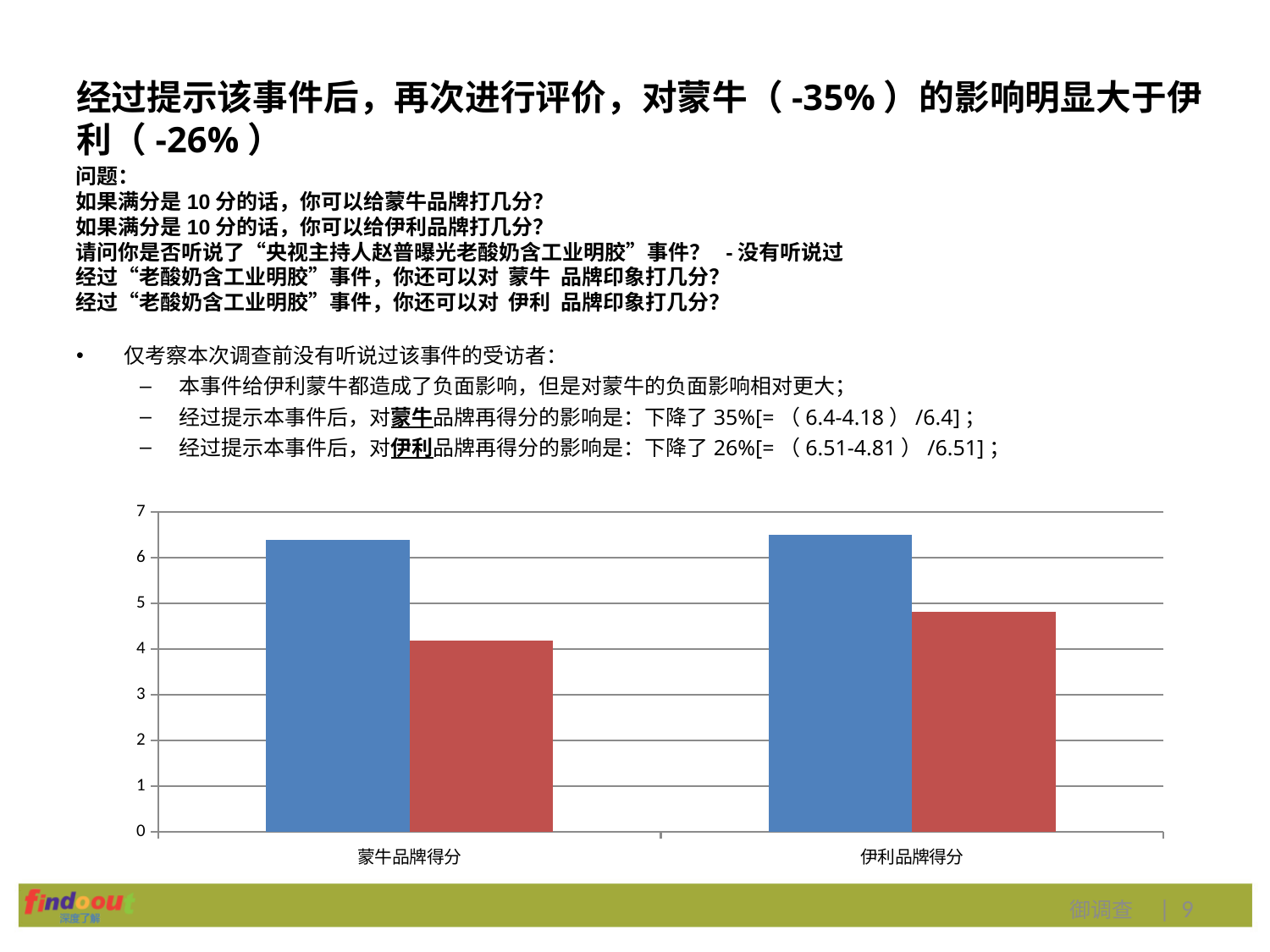
Is the value of the red bar for 蒙牛品牌得分 greater or less than 5? less What are the two category labels on the x axis of the chart? 蒙牛品牌得分, 伊利品牌得分 For 伊利品牌得分, which bar is taller, the blue one or the red one? the blue one How many categories are shown on the x axis of the chart? 2 Is the value of the blue bar for 伊利品牌得分 greater or less than 6? greater Which category has the taller red bar, 蒙牛品牌得分 or 伊利品牌得分? 伊利品牌得分 Is the value of the red bar for 伊利品牌得分 greater or less than 4? greater Which category has the shortest bar in the chart? 蒙牛品牌得分 For 蒙牛品牌得分, which bar is taller, the blue one or the red one? the blue one What kind of chart is shown on the slide? bar chart What is the highest value shown on the y axis of the chart? 7